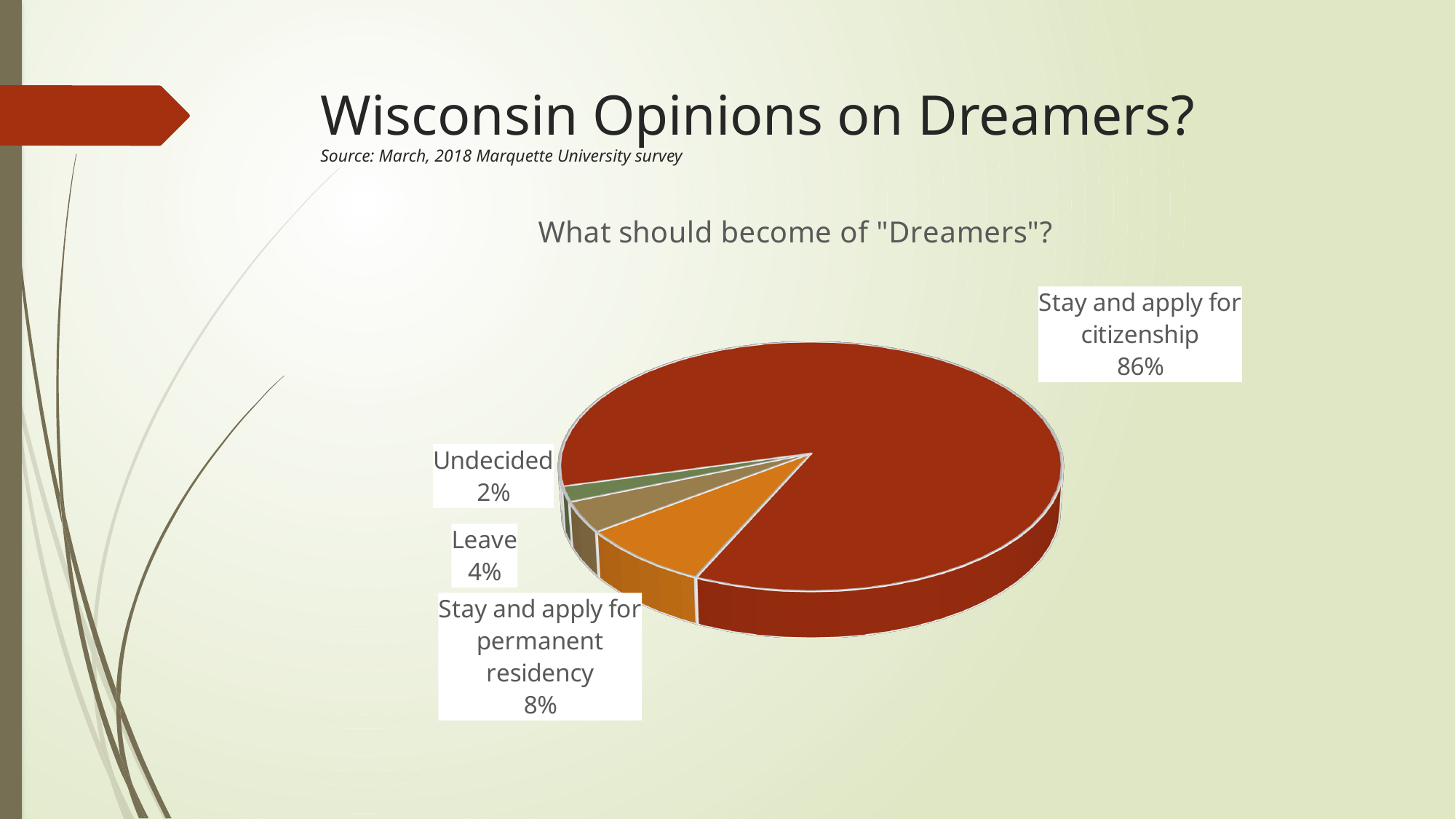
What is the difference in percentage points between "Stay and apply for citizenship" and "Stay and apply for permanent residency"? 78 What is the source of the survey data cited on the slide? March, 2018 Marquette University survey Which category has the largest share of the pie? Stay and apply for citizenship How many categories are shown in the pie chart? 4 Which is larger, the share for "Leave" or the share for "Undecided"? Leave What percentage of respondents chose "Stay and apply for permanent residency"? 8% What percentage of respondents chose "Leave"? 4% What percentage of respondents were "Undecided"? 2% What percentage of respondents chose "Stay and apply for citizenship"? 86% What is the title of the chart? What should become of "Dreamers"? What kind of chart is shown on the slide? Pie chart Which category has the smallest share of the pie? Undecided